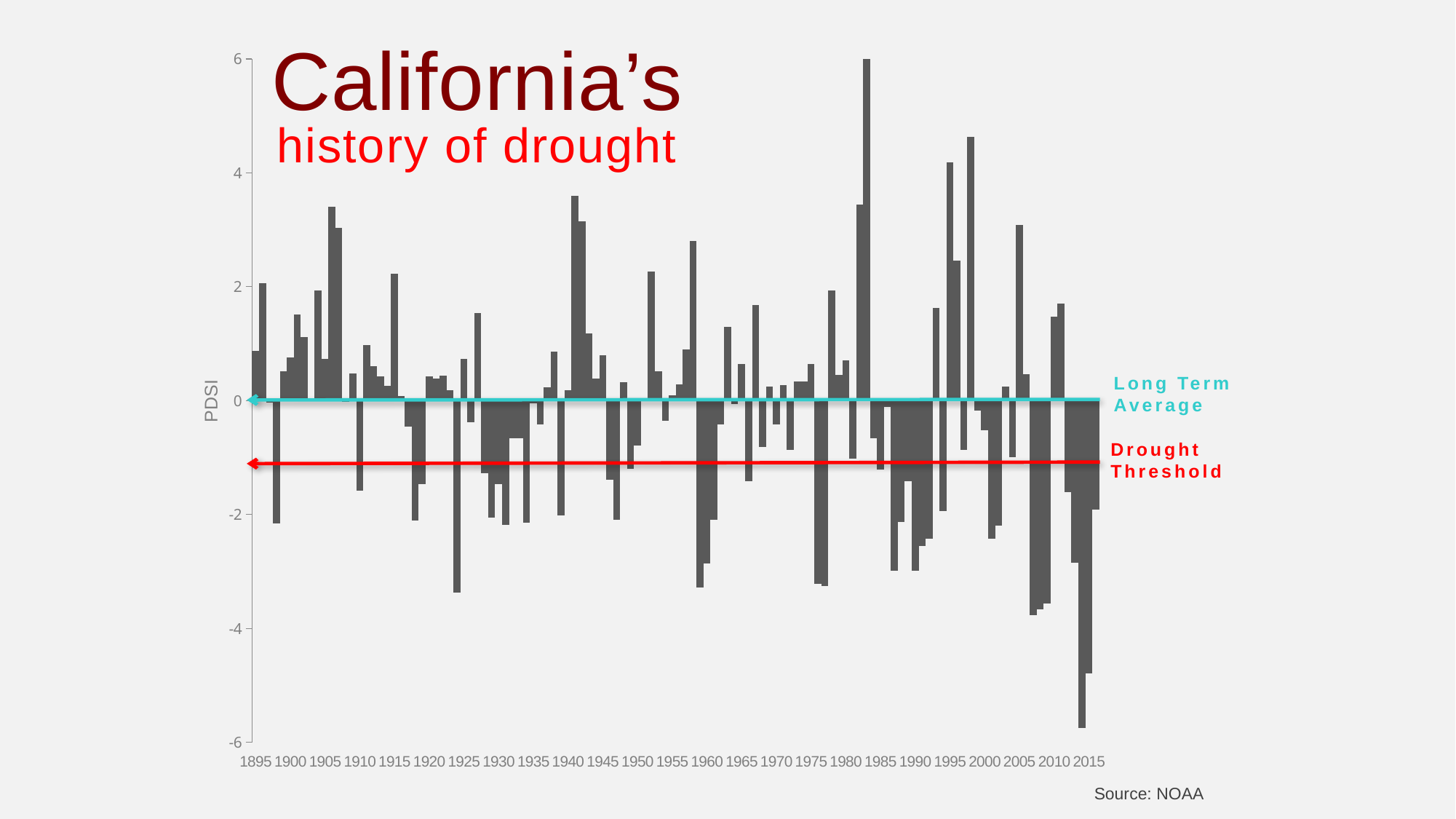
Is the value for 1895, the first bar on the chart, greater or less than 2? less Is the lowest bar on the chart greater or less than -4? less What is the title of the chart? California's history of drought What is the first year labelled on the x axis? 1895 At what PDSI value is the Long Term Average line drawn? 0 What is the last year labelled on the x axis? 2015 What is the maximum value shown on the y axis? 6 What kind of chart is shown on the slide? bar chart Is the highest bar on the chart greater or less than 4? greater Which line is drawn lower on the chart, the Drought Threshold or the Long Term Average? Drought Threshold What label is shown on the y axis of the chart? PDSI